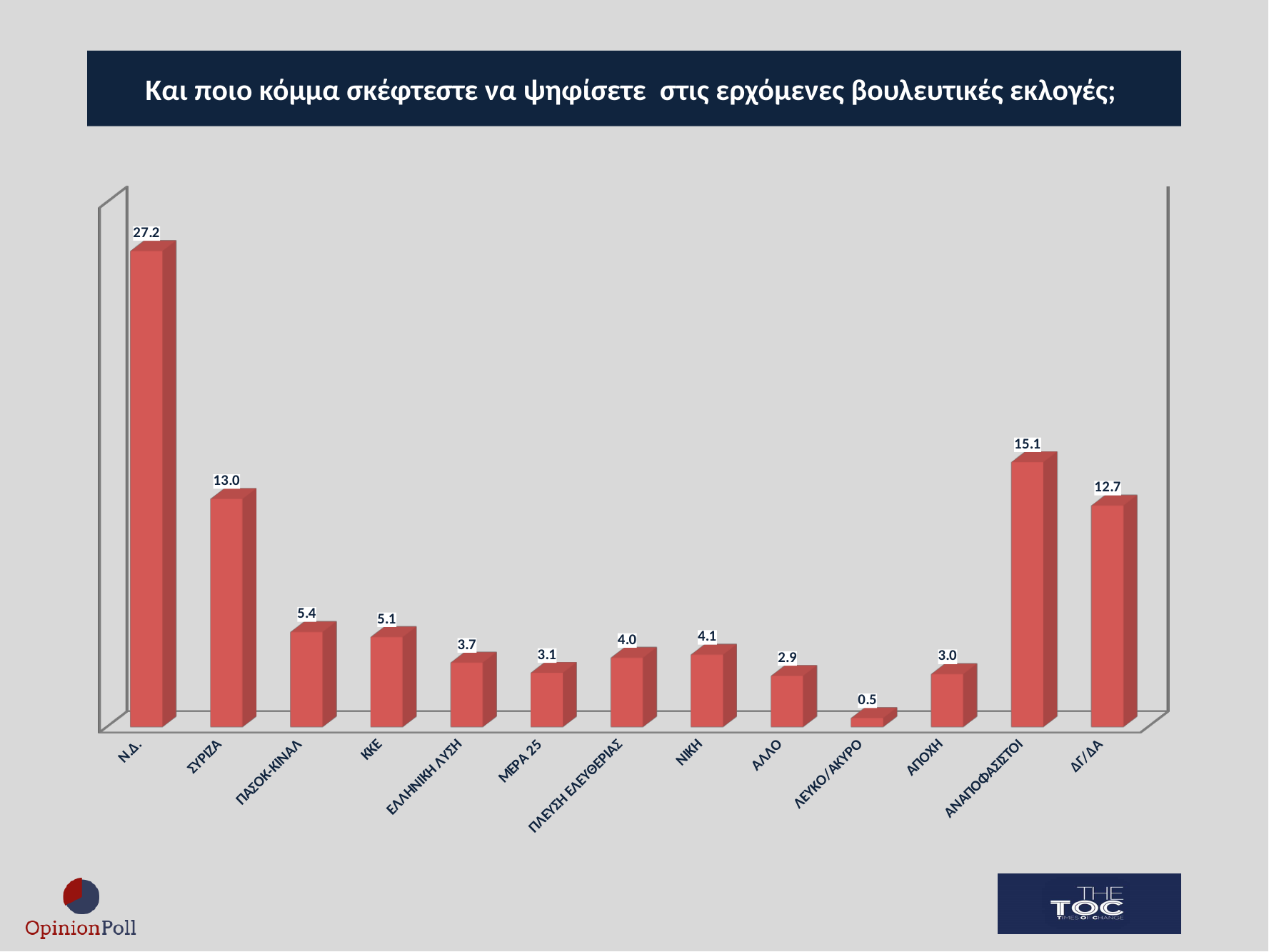
What is the difference between the values for Ν.Δ. and ΣΥΡΙΖΑ? 14.2 Which is larger, the value for ΠΑΣΟΚ-ΚΙΝΑΛ or the value for ΚΚΕ? ΠΑΣΟΚ-ΚΙΝΑΛ Which is larger, the value for ΑΝΑΠΟΦΑΣΙΣΤΟΙ or the value for ΔΓ/ΔΑ? ΑΝΑΠΟΦΑΣΙΣΤΟΙ Which category has the lowest value? ΛΕΥΚΟ/ΑΚΥΡΟ What is the value for ΑΝΑΠΟΦΑΣΙΣΤΟΙ? 15.1 What is the value for Ν.Δ.? 27.2 How many categories are shown on the x axis? 13 What is the value for ΛΕΥΚΟ/ΑΚΥΡΟ? 0.5 Which category has the highest value? Ν.Δ. What is the value for ΣΥΡΙΖΑ? 13.0 What kind of chart is shown on the slide? bar chart What is the difference between the values for ΝΙΚΗ and ΠΛΕΥΣΗ ΕΛΕΥΘΕΡΙΑΣ? 0.1